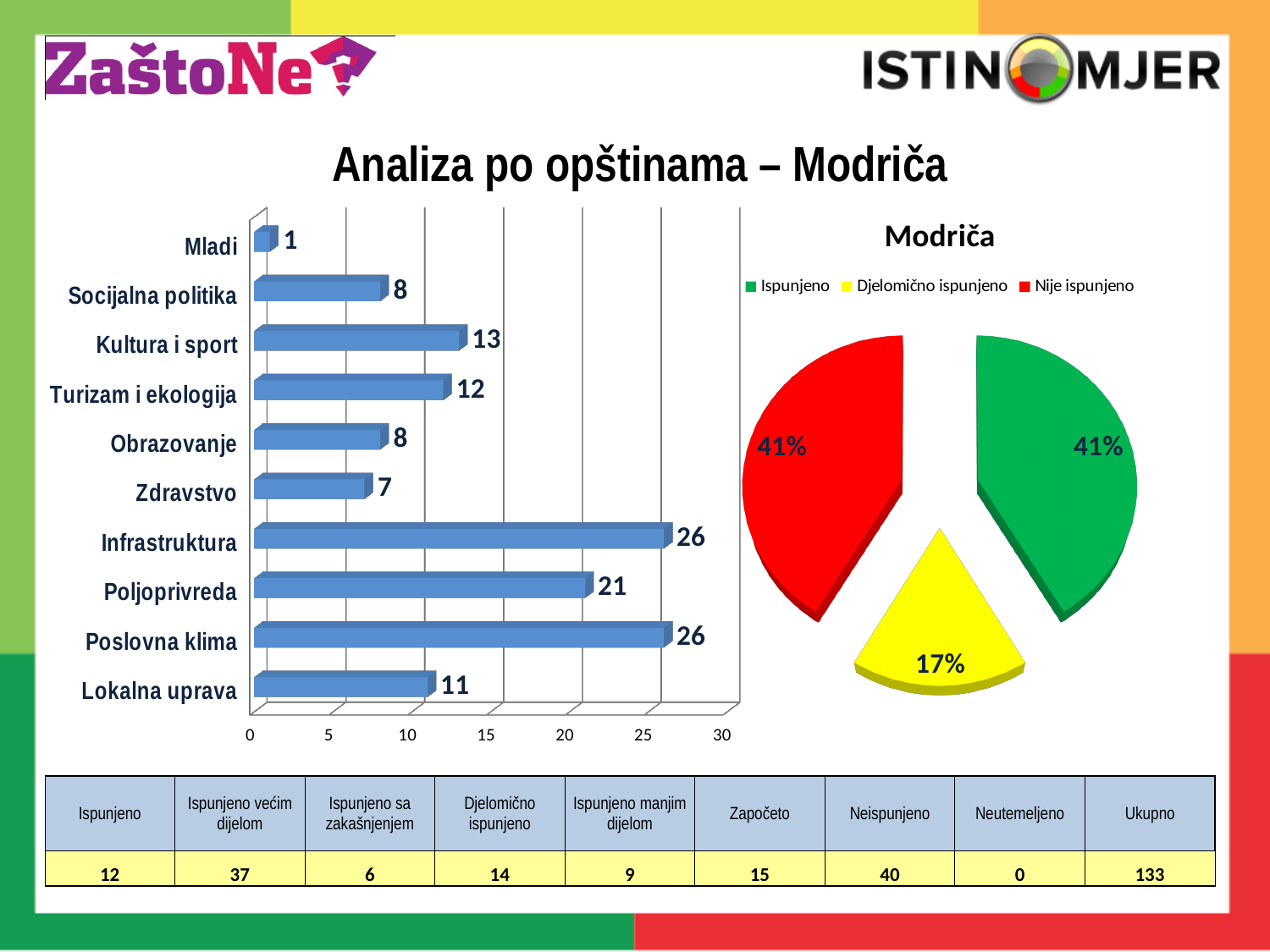
In the bar chart on the left, what is the difference between Poljoprivreda and Kultura i sport? 8 In the pie chart titled Modriča, what colour is the Ispunjeno slice? green In the bar chart on the left, what is the value for Lokalna uprava? 11 In the bar chart on the left, what is the value for Infrastruktura? 26 In the bar chart on the left, what is the value for Zdravstvo? 7 In the pie chart titled Modriča, what share is Djelomično ispunjeno? 17% What kind of chart is the chart on the left of the slide? bar chart In the pie chart titled Modriča, what share is Nije ispunjeno? 41% How many categories does the bar chart on the left show? 10 How many entries does the legend of the pie chart titled Modriča list? 3 In the bar chart on the left, which is larger, Turizam i ekologija or Obrazovanje? Turizam i ekologija In the bar chart on the left, which category has the lowest value? Mladi